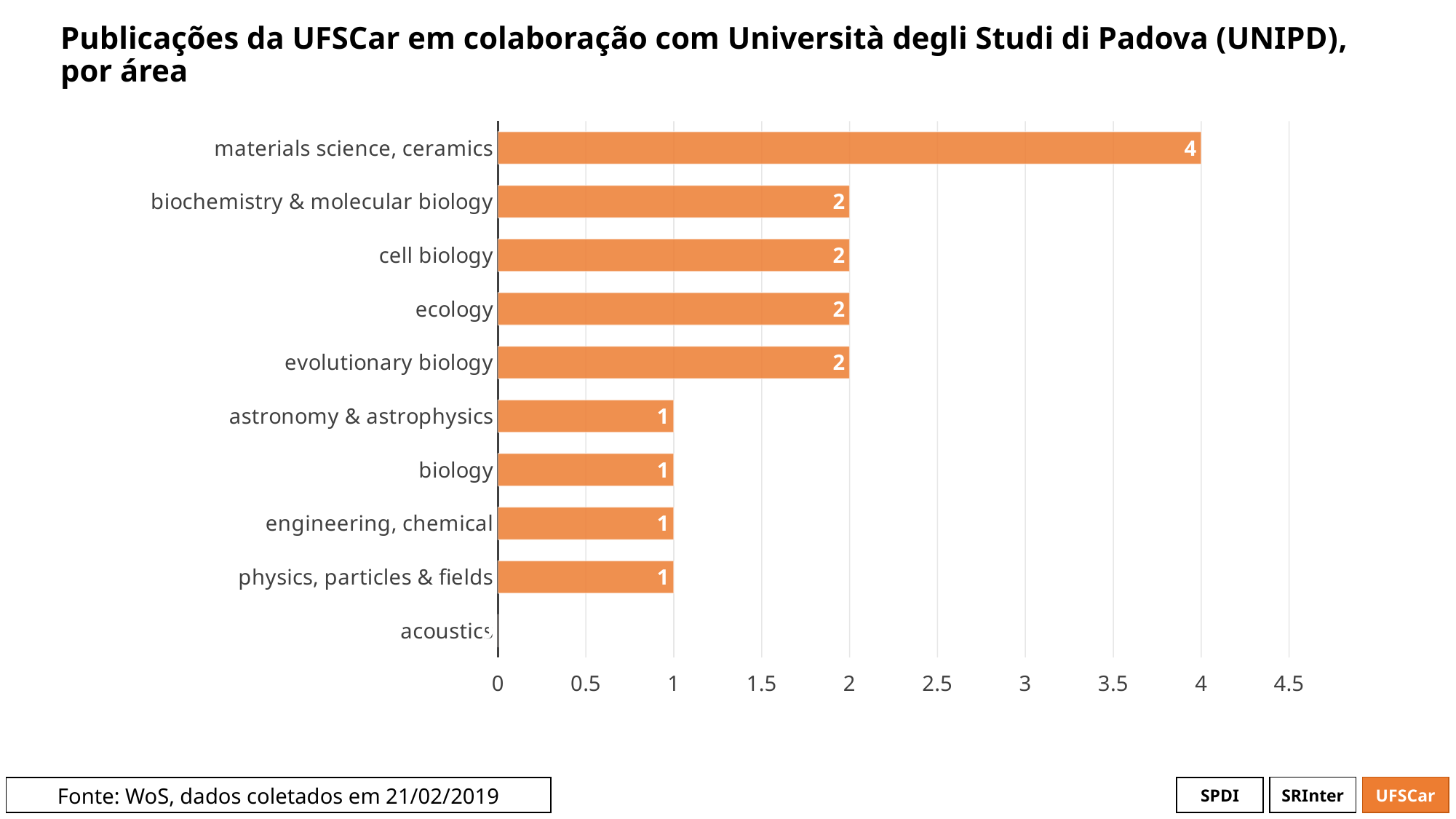
Which area has the highest value? materials science, ceramics What is the value for biochemistry & molecular biology? 2 Which is larger, the value for evolutionary biology or the value for biology? evolutionary biology What is the value for materials science, ceramics? 4 Which area has the lowest value? acoustics What is the value for astronomy & astrophysics? 1 What is the value for ecology? 2 What is the source of the data stated on the slide? WoS, dados coletados em 21/02/2019 What is the difference between the values for materials science, ceramics and cell biology? 2 What kind of chart is shown on the slide? bar chart How many areas are shown on the chart? 10 Is the value for materials science, ceramics greater or less than 3? greater